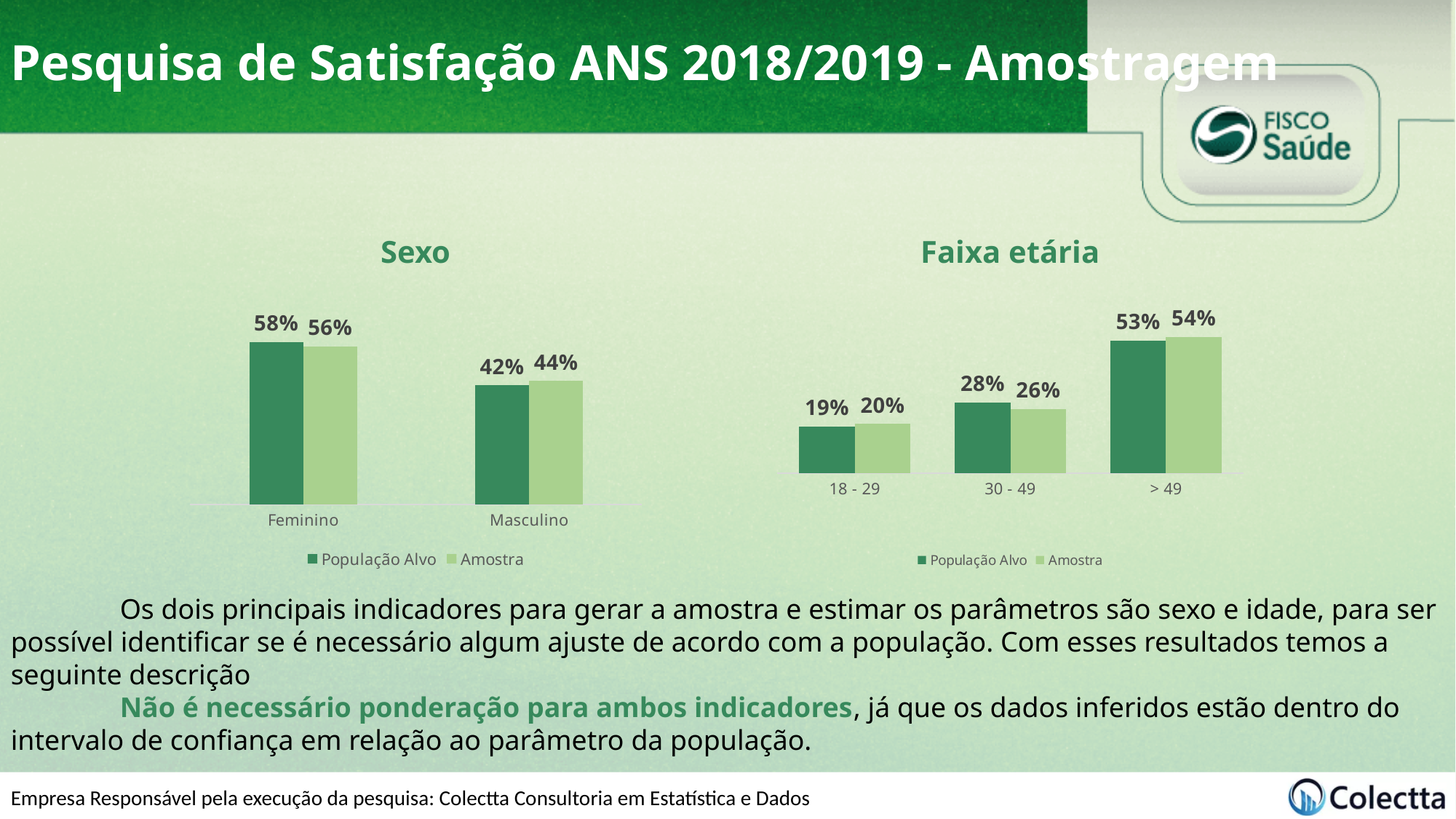
What type of chart is the 'Faixa etária' chart? Bar chart In the 'Faixa etária' chart, which age group has the lowest População Alvo value? 18 - 29 In the 'Faixa etária' chart, what is the value of População Alvo for the > 49 group? 53% In the 'Faixa etária' chart, which age group has the highest Amostra value? > 49 In the 'Sexo' chart, what is the value of Amostra for Masculino? 44% In the 'Sexo' chart, what is the difference between the População Alvo values for Feminino and Masculino? 16% In the 'Sexo' chart, which is larger for Feminino: População Alvo or Amostra? População Alvo In the 'Faixa etária' chart, what is the difference between the Amostra values for > 49 and 18 - 29? 34% In the 'Faixa etária' chart, what is the value of Amostra for the 30 - 49 group? 26% How many series does the legend of the 'Sexo' chart list? 2 In the 'Sexo' chart, what is the value of População Alvo for Feminino? 58% How many age groups are shown in the 'Faixa etária' chart? 3